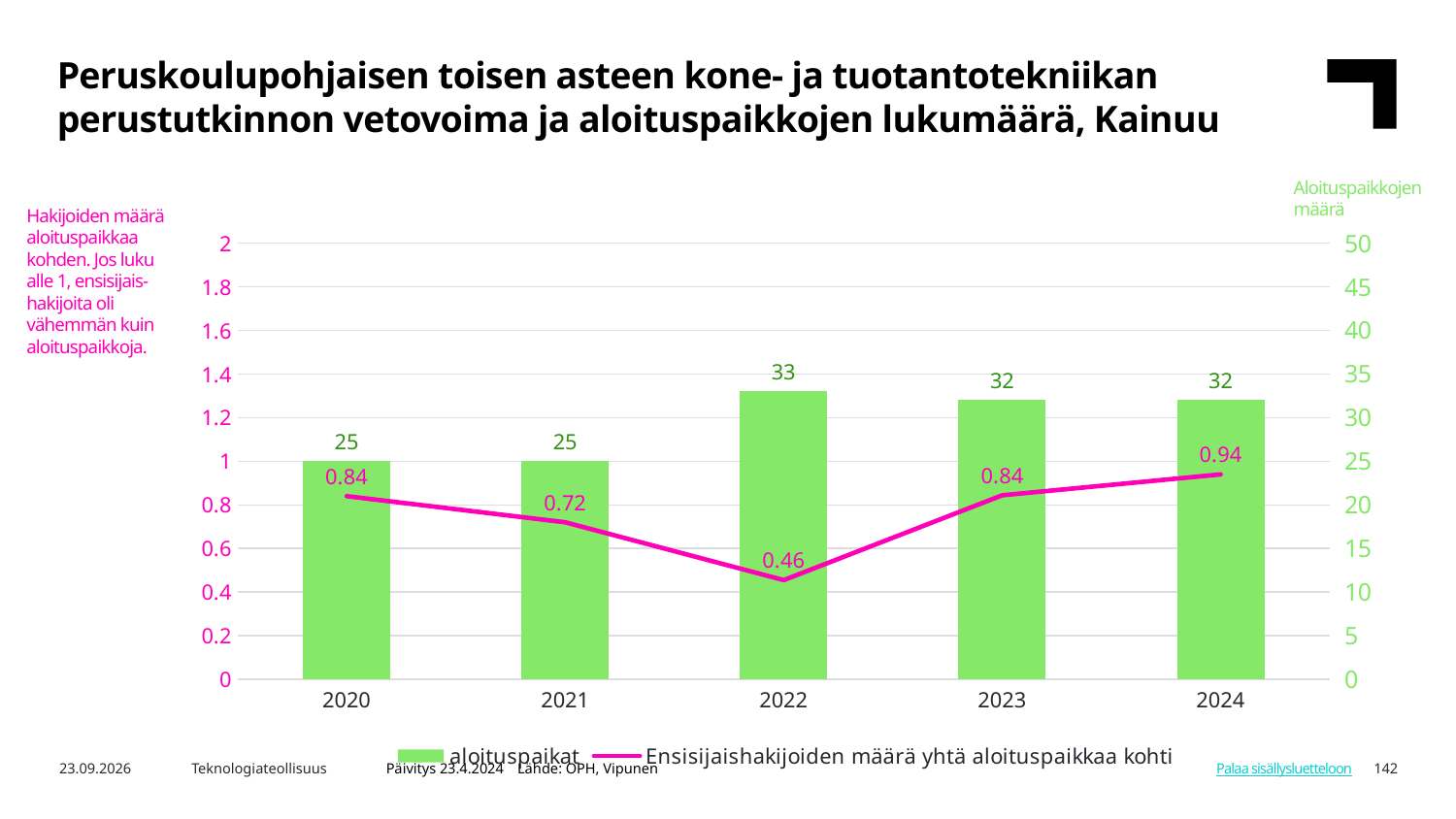
Does the Ensisijaishakijoiden määrä yhtä aloituspaikkaa kohti line rise or fall from 2022 to 2024? Rise What kind of chart is shown on the slide? Combined bar and line chart Which year has the lowest value of Ensisijaishakijoiden määrä yhtä aloituspaikkaa kohti? 2022 How many years are shown on the x axis? 5 Which is larger, the Ensisijaishakijoiden määrä yhtä aloituspaikkaa kohti value in 2020 or in 2021? 2020 What is the value of aloituspaikat in 2022? 33 What is the difference between the Ensisijaishakijoiden määrä yhtä aloituspaikkaa kohti values for 2024 and 2022? 0.48 What is the difference in aloituspaikat between 2022 and 2020? 8 What is the value of Ensisijaishakijoiden määrä yhtä aloituspaikkaa kohti in 2024? 0.94 How many series does the legend list? 2 What is the value of Ensisijaishakijoiden määrä yhtä aloituspaikkaa kohti in 2021? 0.72 Which year has the highest number of aloituspaikat? 2022